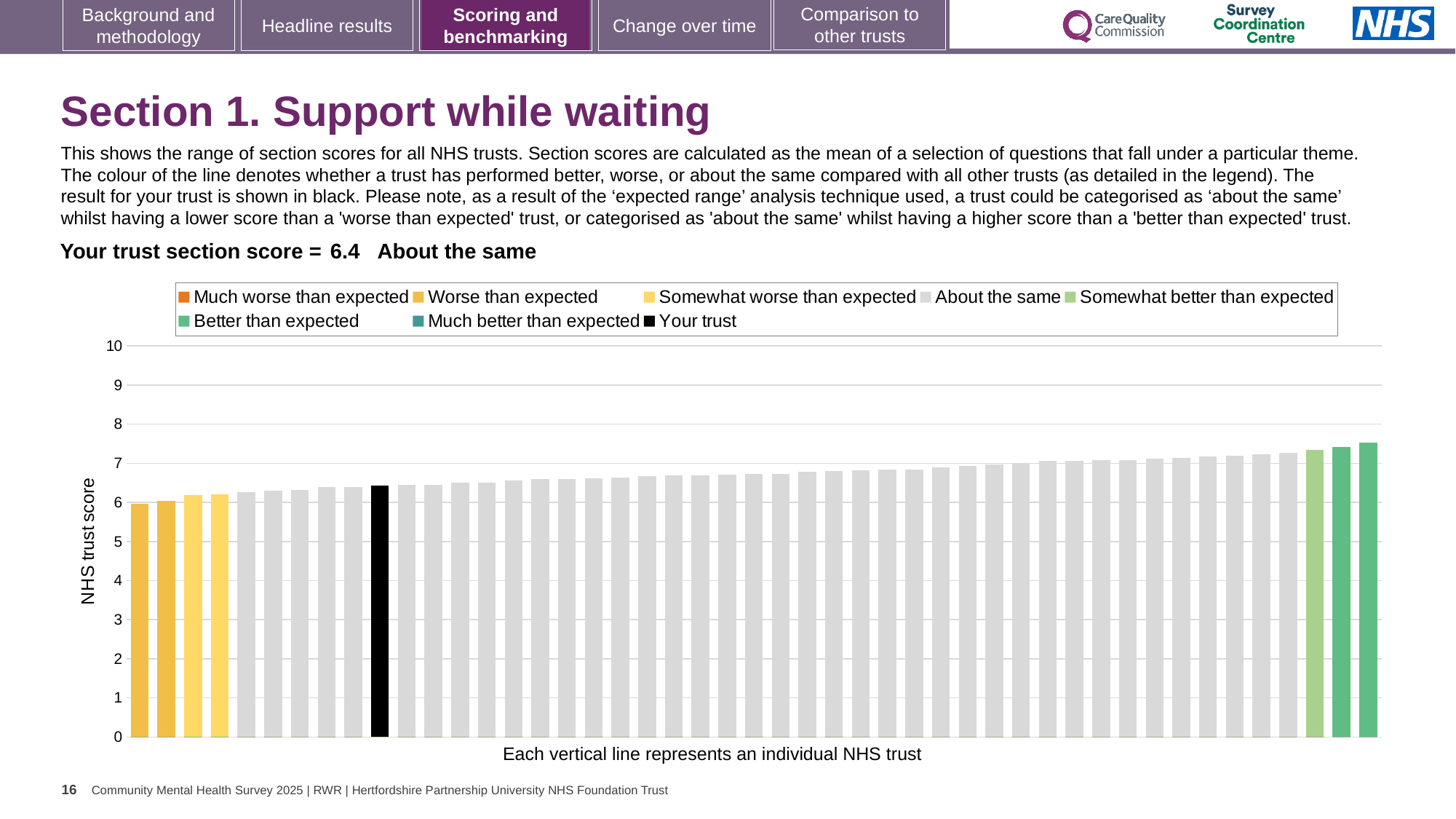
Is the value of the shortest bar in the chart greater or less than 5? greater What kind of chart is shown on the slide? Bar chart What is the section score for your trust shown on the slide? 6.4 Do the bar values rise or fall from left to right along the x axis? Rise Is the value of the black 'Your trust' bar greater or less than 5? greater How many entries does the chart legend list? 8 What is the label on the vertical axis of the chart? NHS trust score How many bars are coloured green (better than expected categories) in the chart? 3 What colour is the bar representing your trust in the chart? Black Which is taller, the black 'Your trust' bar or the rightmost bar? The rightmost bar Is the value of the tallest bar in the chart greater or less than 8? less How many bars are coloured yellow (worse than expected categories) in the chart? 4